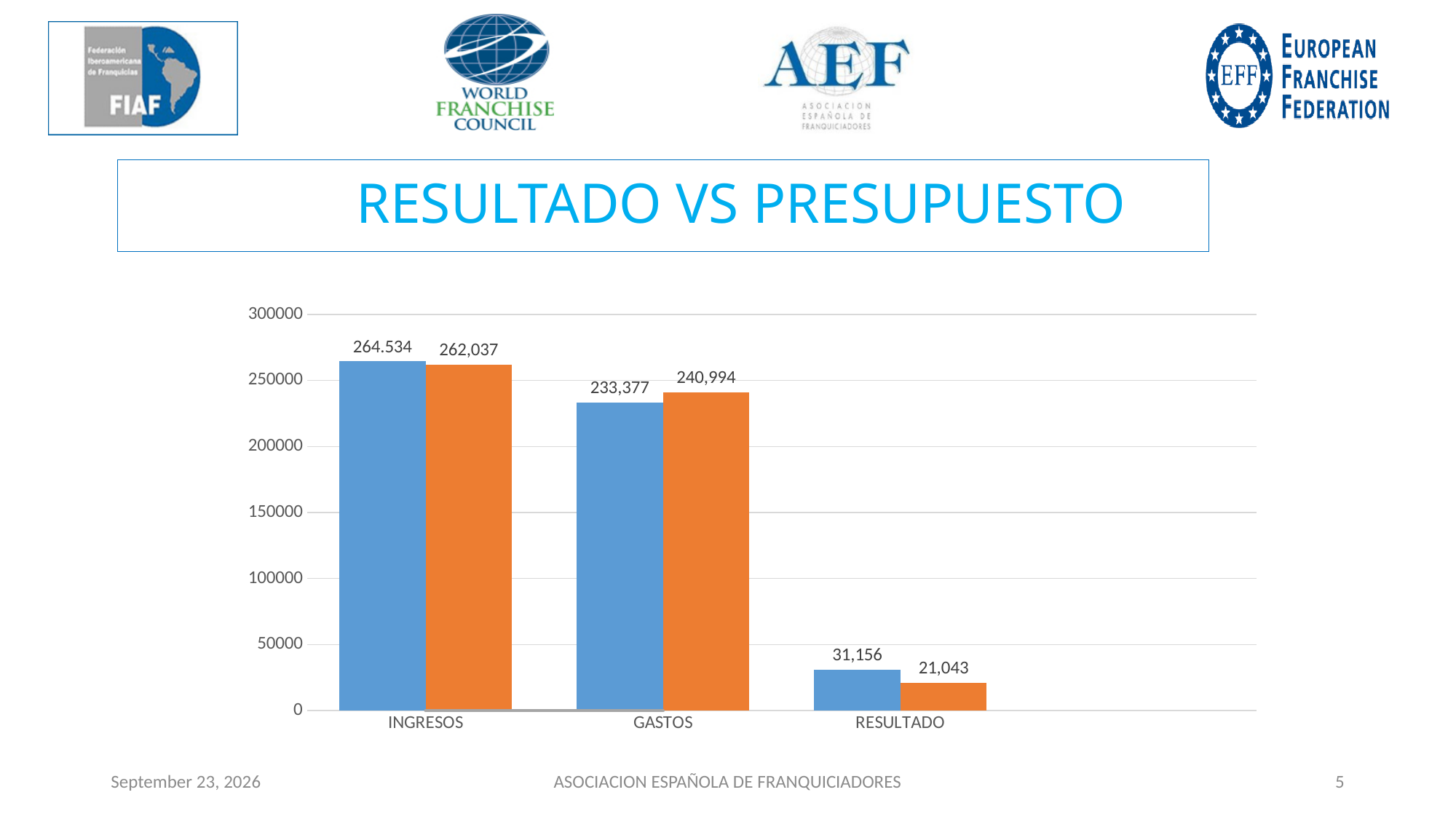
What is the value of the blue bar for GASTOS? 233,377 What is the value of the blue bar for INGRESOS? 264.534 Which category has the lowest values in the chart? RESULTADO What is the difference between the orange and blue bars for GASTOS? 7,617 What is the value of the orange bar for INGRESOS? 262,037 For GASTOS, which bar is larger, the blue or the orange one? orange Which category has the highest blue bar? INGRESOS What is the value of the orange bar for RESULTADO? 21,043 What is the difference between the blue and orange bars for RESULTADO? 10,113 What is the value of the blue bar for RESULTADO? 31,156 What is the value of the orange bar for GASTOS? 240,994 Is the value of the orange bar for RESULTADO greater or less than 50000? less